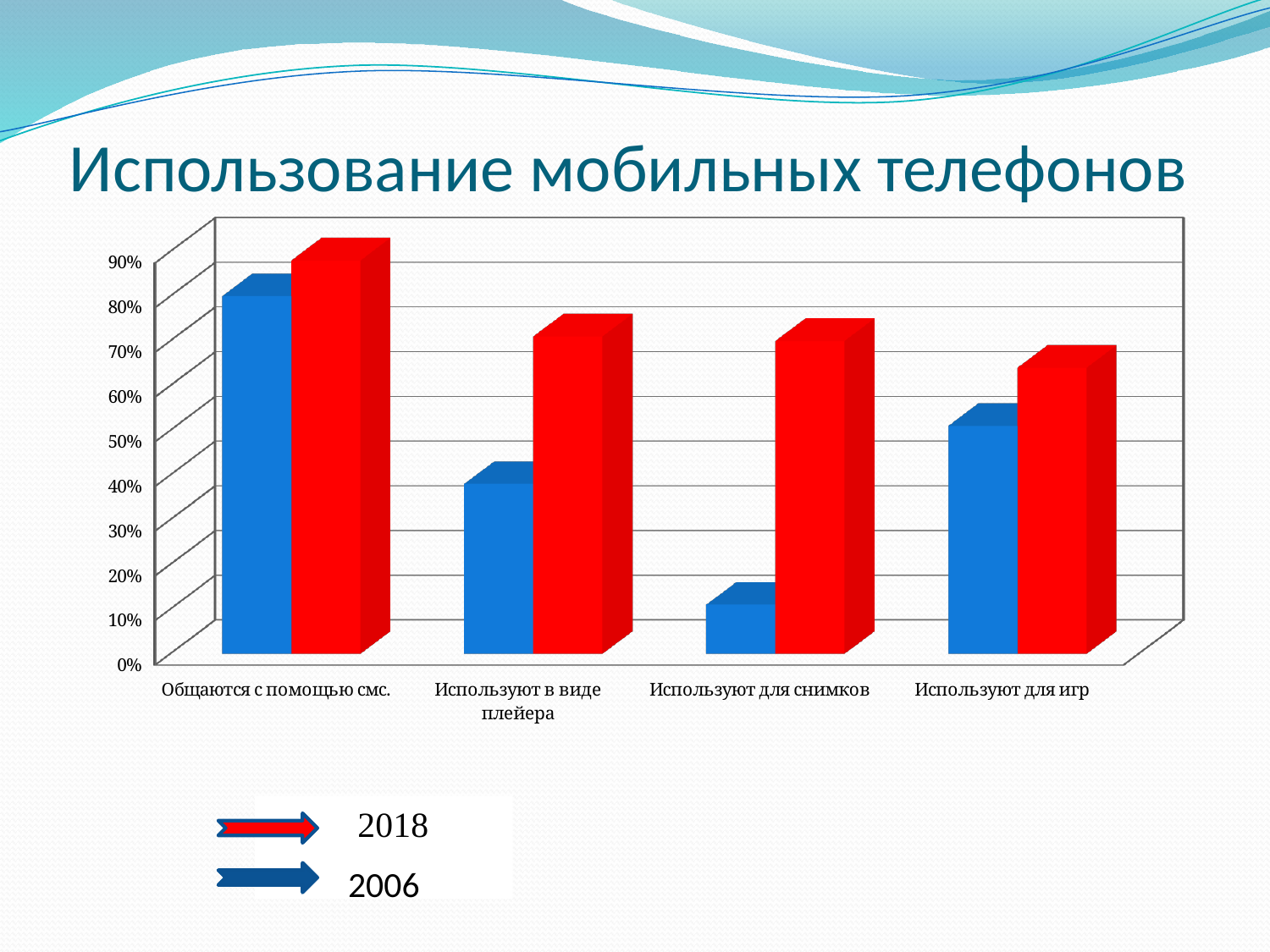
For "Используют для снимков", which year has the larger value, 2018 or 2006? 2018 Is the 2018 value for "Общаются с помощью смс." greater or less than 80%? greater Is the 2006 value for "Используют в виде плейера" greater or less than 50%? less What is the title of the chart? Использование мобильных телефонов Which category has the lowest value for 2006? Используют для снимков What kind of chart is shown on the slide? bar chart Which category has the highest value for 2018? Общаются с помощью смс. How many series does the legend list? 2 Is the 2006 value for "Используют для снимков" greater or less than 20%? less How many categories are shown on the x axis of the chart? 4 Which category has the highest value for 2006? Общаются с помощью смс. Which colour represents the year 2018 in the chart? red